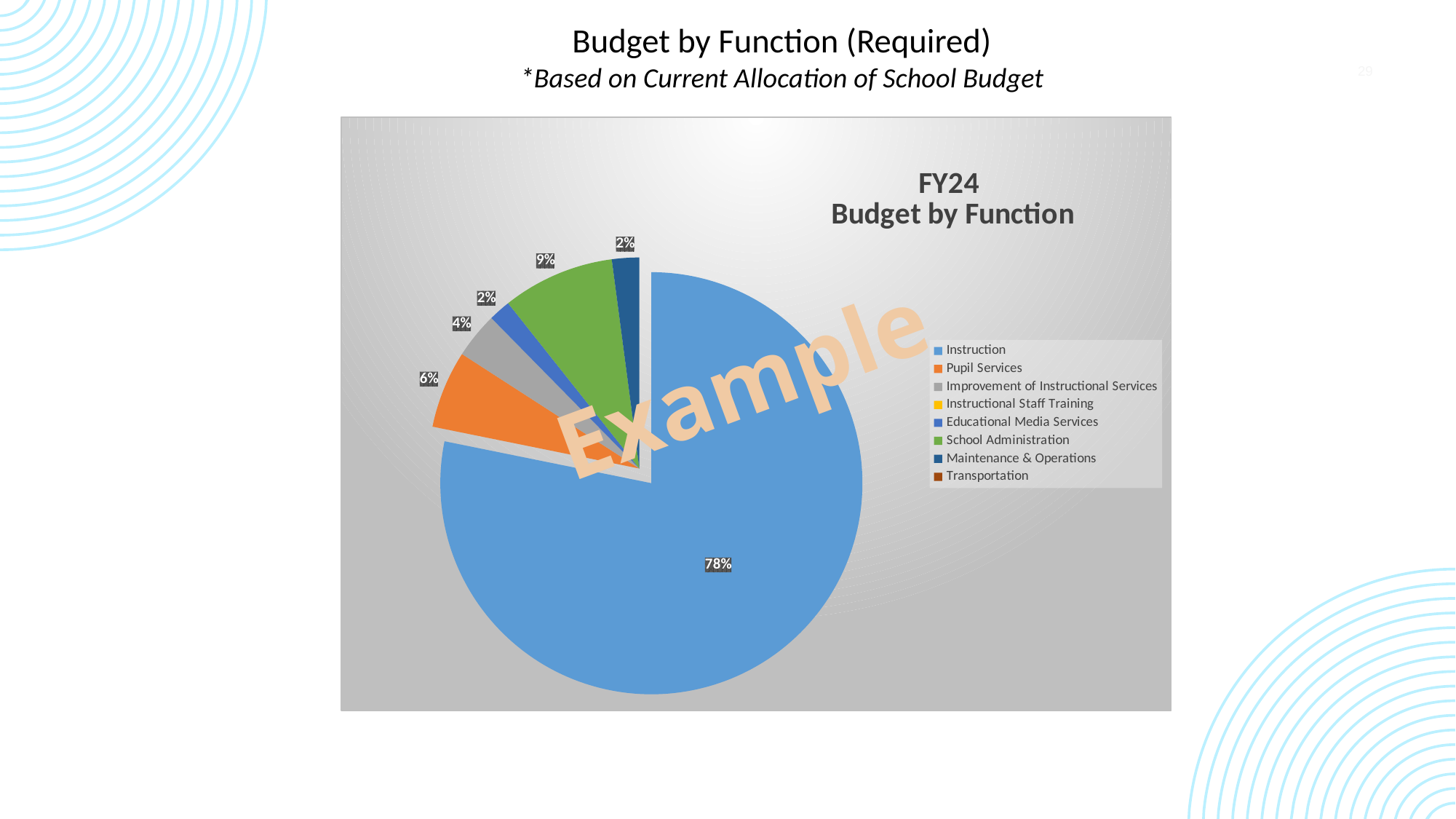
What kind of chart is shown on the slide? pie chart What share of the FY24 budget goes to Pupil Services? 6% How many entries does the legend list? 8 Which has a larger share of the budget, Improvement of Instructional Services or Pupil Services? Pupil Services What is the title of the chart? FY24 Budget by Function What share of the FY24 budget goes to Maintenance & Operations? 2% What share of the FY24 budget goes to Improvement of Instructional Services? 4% What share of the FY24 budget goes to School Administration? 9% What is the difference in percentage points between the Instruction share and the School Administration share? 69 percentage points Which has a larger share of the budget, Pupil Services or School Administration? School Administration What share of the FY24 budget goes to Instruction? 78% Which function has the largest share of the FY24 budget? Instruction